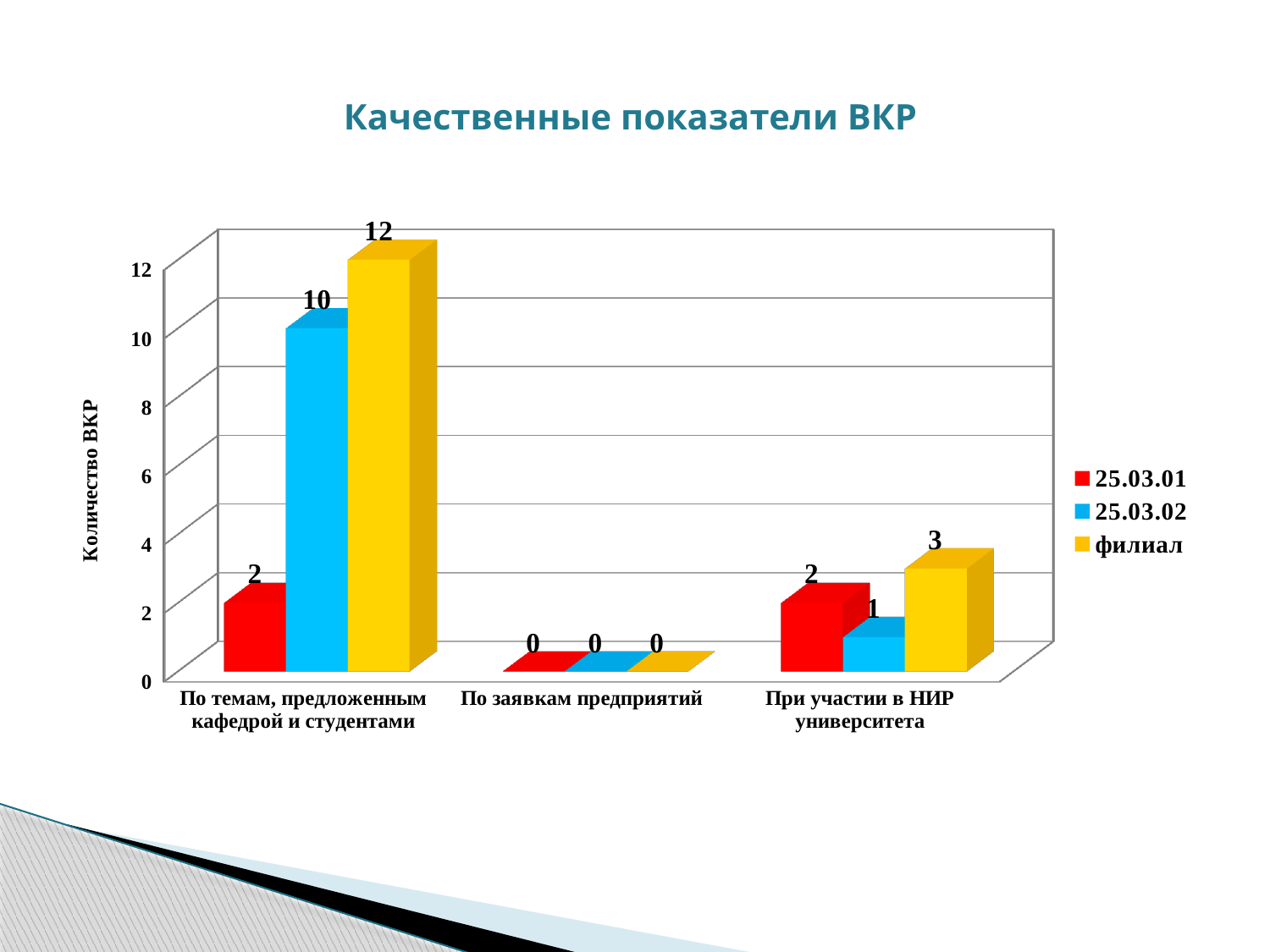
Which series has the lowest value in the category 'При участии в НИР университета'? 25.03.02 How many categories are shown on the x axis? 3 What is the value for филиал in the category 'По темам, предложенным кафедрой и студентами'? 12 Which series has the highest value in the category 'По темам, предложенным кафедрой и студентами'? филиал How many series does the legend list? 3 What kind of chart is shown on the slide? Bar chart What is the value for 25.03.01 in the category 'По заявкам предприятий'? 0 What is the difference between the филиал value and the 25.03.01 value in the category 'По темам, предложенным кафедрой и студентами'? 10 Which is larger: the 25.03.02 value for 'По темам, предложенным кафедрой и студентами' or the филиал value for 'При участии в НИР университета'? 25.03.02 value for 'По темам, предложенным кафедрой и студентами' What is the label of the vertical axis? Количество ВКР What is the value for 25.03.02 in the category 'При участии в НИР университета'? 1 What is the title of the chart? Качественные показатели ВКР